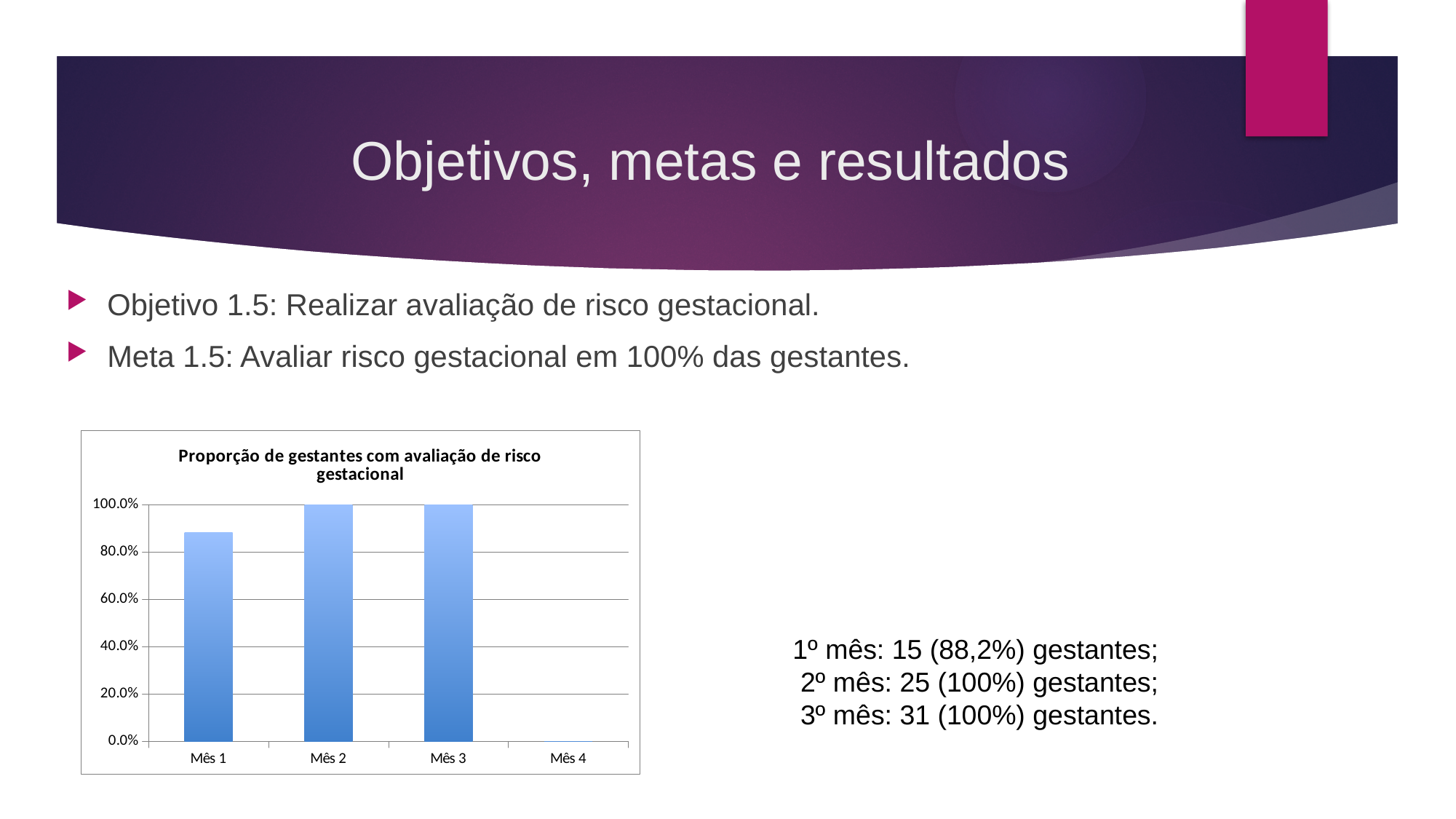
What kind of chart is shown on the slide? bar chart Does the value rise or fall from Mês 1 to Mês 2? rise What is the value for Mês 4 in the chart? 0.0% Which month has the lowest value in the chart? Mês 4 How many months (categories) are shown on the x axis of the chart? 4 Which is larger, the value for Mês 1 or the value for Mês 2? Mês 2 Is the value for Mês 1 greater or less than 100.0%? less What is the value for Mês 2 in the chart? 100.0% What is the value for Mês 3 in the chart? 100.0% What is the title of the chart? Proporção de gestantes com avaliação de risco gestacional What is the difference between the values for Mês 2 and Mês 4? 100.0% Is the value for Mês 1 greater or less than 80.0%? greater